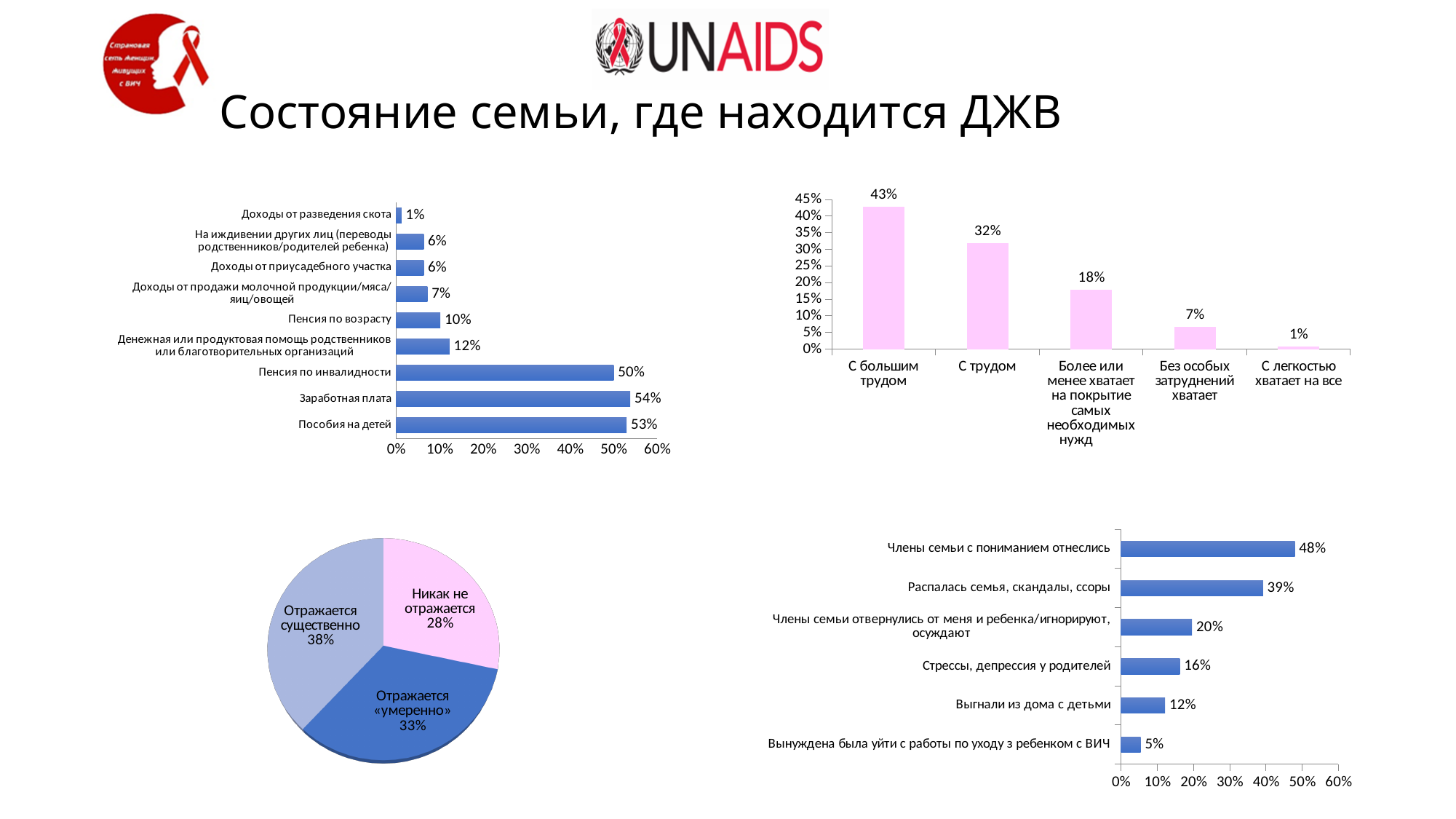
In the bottom-left pie chart, what share does Отражается существенно have? 38% In the bottom-right bar chart, what is the value for Выгнали из дома с детьми? 12% What kind of chart is the bottom-left chart? pie chart In the top-right bar chart, what is the value for С трудом? 32% In the top-left bar chart, which category has the lowest value? Доходы от разведения скота In the top-right bar chart, which category has the highest value? С большим трудом In the bottom-left pie chart, which slice is the smallest? Никак не отражается In the top-left bar chart, what is the value for Заработная плата? 54% In the bottom-right bar chart, which is larger: Распалась семья, скандалы, ссоры or Стрессы, депрессия у родителей? Распалась семья, скандалы, ссоры How many categories are shown in the top-left bar chart? 9 In the top-left bar chart, what is the difference between Пособия на детей and Пенсия по инвалидности? 3% In the top-right bar chart, do the values rise or fall from left to right along the x axis? fall